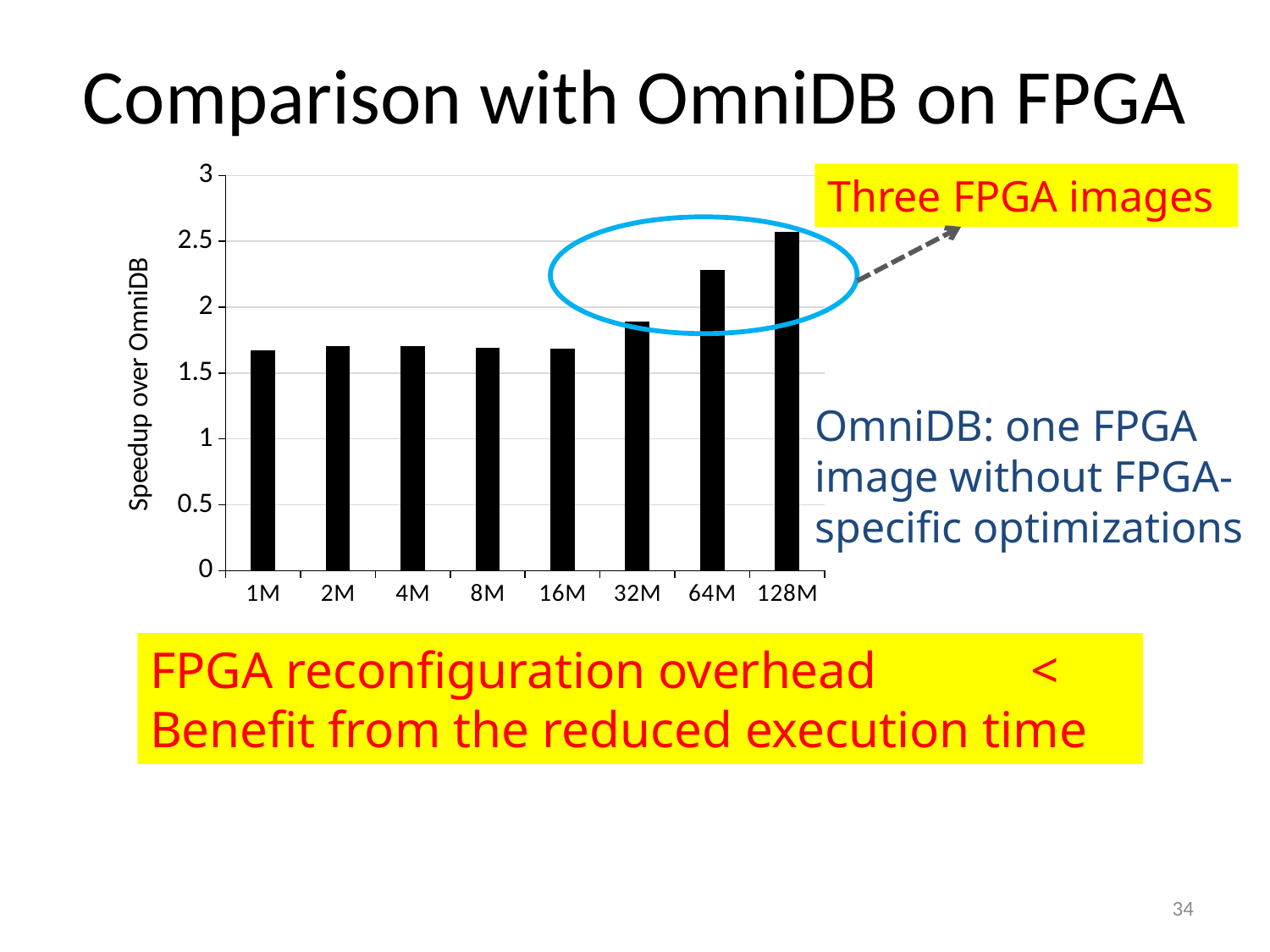
Which has a larger speedup over OmniDB, 64M or 32M? 64M What is the label of the y axis of the chart? Speedup over OmniDB Is the speedup for 64M greater or less than 2? greater Is the speedup for 1M greater or less than 1.5? greater Do the speedup values generally rise or fall as the data size increases from 16M to 128M? rise Is the speedup for 32M greater or less than 2? less What kind of chart is shown on the slide? bar chart Which category has the highest speedup over OmniDB? 128M Which has a larger speedup over OmniDB, 128M or 64M? 128M How many categories are shown on the x axis of the chart? 8